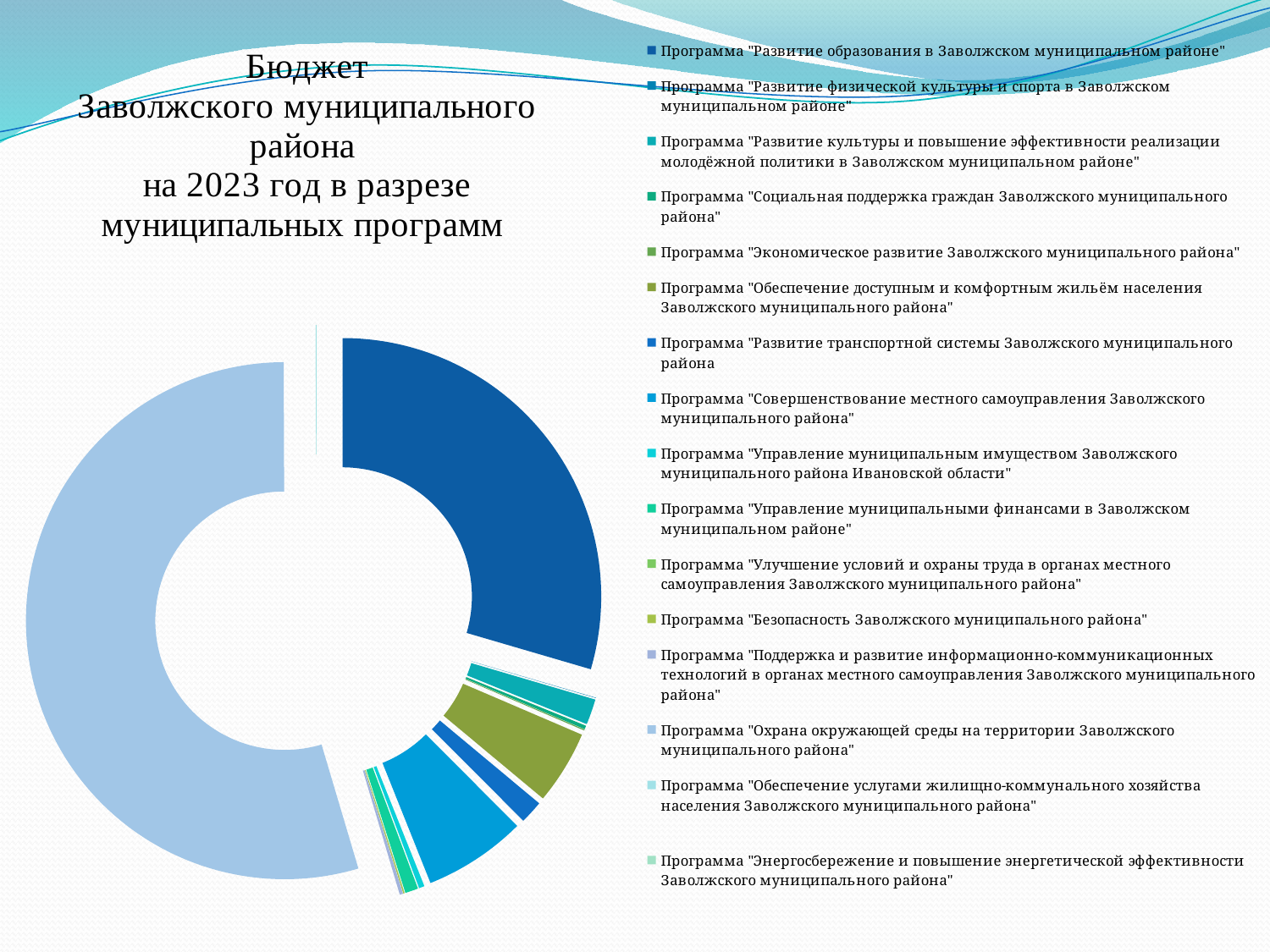
What kind of chart is shown on the slide? Doughnut (pie) chart How many programmes (categories) does the legend of the chart list? 16 Which slice is larger: the dark blue slice for Программа "Развитие образования в Заволжском муниципальном районе" or the large light blue slice? the large light blue slice Which legend entry is listed first in the chart's legend? Программа "Развитие образования в Заволжском муниципальном районе" Is the share of the dark blue slice for Программа "Развитие образования в Заволжском муниципальном районе" greater or less than 10% of the doughnut? greater What is the title of the chart on the slide? Бюджет Заволжского муниципального района на 2023 год в разрезе муниципальных программ Is the share of the dark blue slice for Программа "Развитие образования в Заволжском муниципальном районе" greater or less than 50% of the doughnut? less